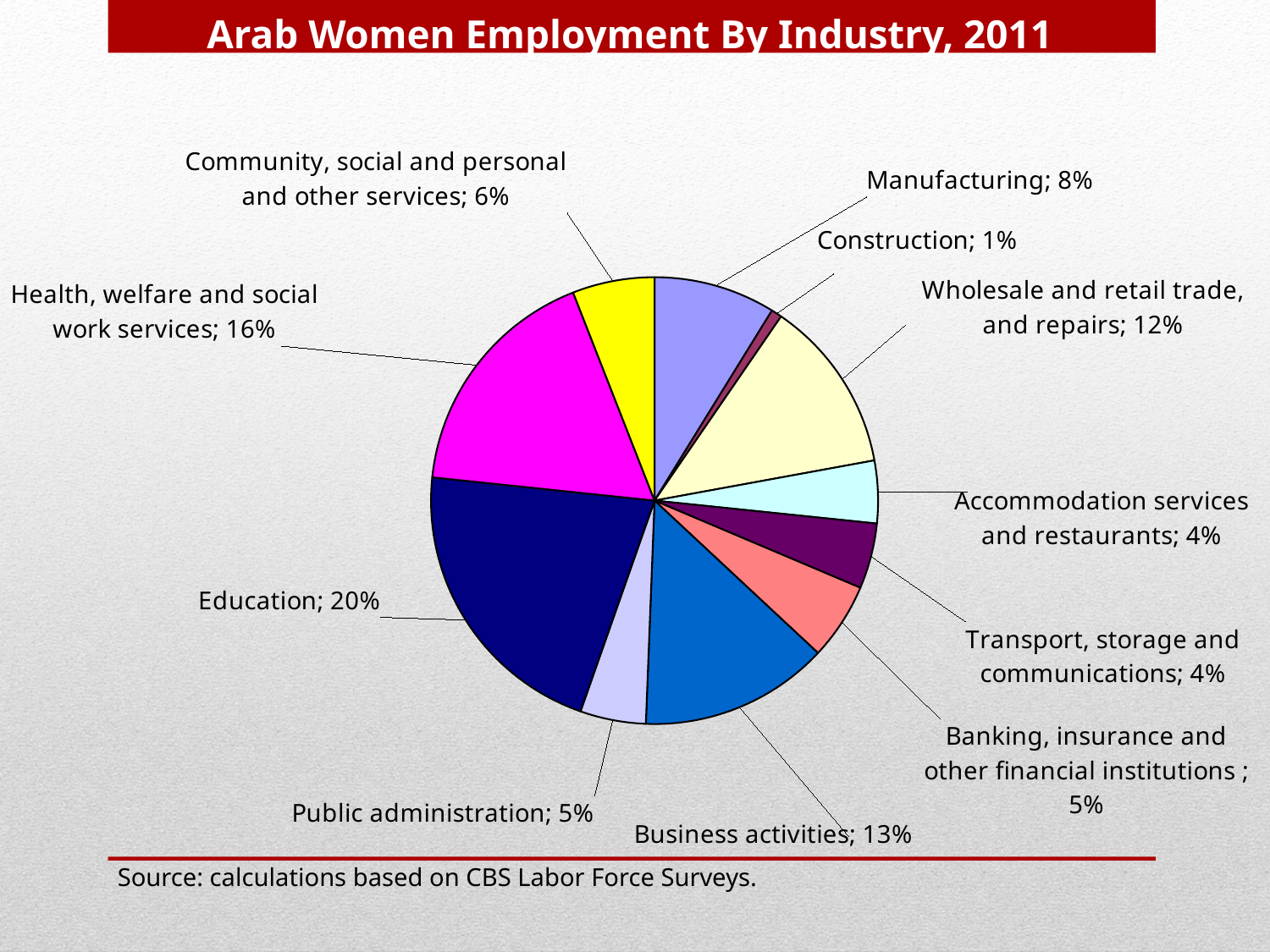
Which is larger, the share for Wholesale and retail trade, and repairs or the share for Manufacturing? Wholesale and retail trade, and repairs What is the title of the chart? Arab Women Employment By Industry, 2011 Which industry has the largest share of the pie? Education Which industry has the smallest share of the pie? Construction What share of Arab women employment is in Education? 20% What percentage is shown for Construction? 1% What is the difference between the shares for Education and Manufacturing? 12% What colour is the Education slice? Dark blue What is the value for Business activities? 13% What percentage is shown for Health, welfare and social work services? 16% What kind of chart is shown on the slide? Pie chart How many industry categories are shown in the pie chart? 11